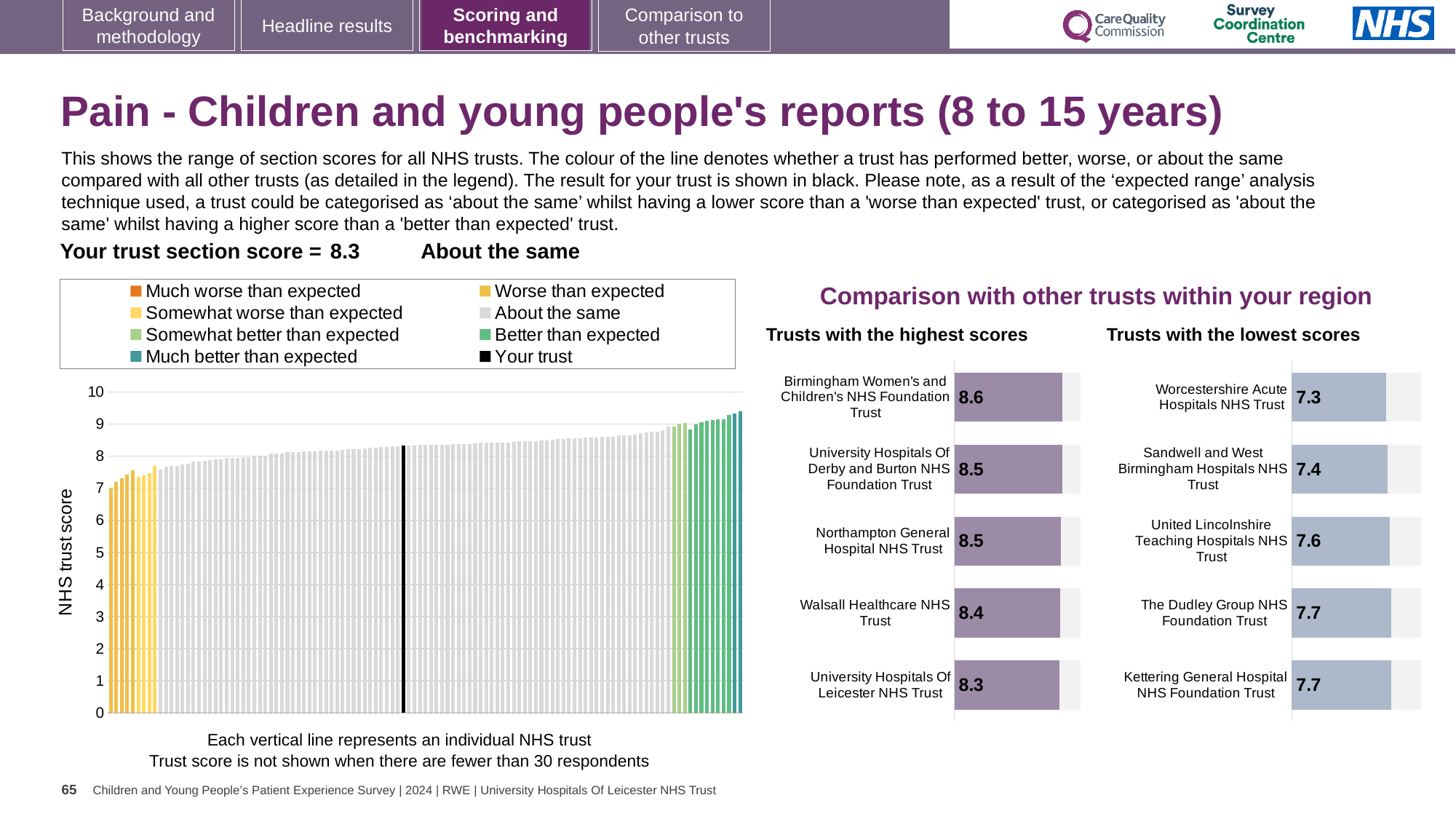
How many entries does the legend of the large chart on the left list? 8 What is the label on the vertical axis of the large chart on the left? NHS trust score What type of chart is the large chart on the left showing NHS trust scores? Bar chart In the 'Trusts with the highest scores' chart, what is the score for Birmingham Women's and Children's NHS Foundation Trust? 8.6 In the large chart on the left, do the trust scores rise or fall from left to right? Rise In the 'Trusts with the lowest scores' chart, which has the higher score: Sandwell and West Birmingham Hospitals NHS Trust or United Lincolnshire Teaching Hospitals NHS Trust? United Lincolnshire Teaching Hospitals NHS Trust In the 'Trusts with the highest scores' chart, how many trusts are listed? 5 In the 'Trusts with the lowest scores' chart, what is the difference between the scores of The Dudley Group NHS Foundation Trust and Worcestershire Acute Hospitals NHS Trust? 0.4 In the 'Trusts with the highest scores' chart, what is the difference between the scores of Birmingham Women's and Children's NHS Foundation Trust and University Hospitals Of Leicester NHS Trust? 0.3 In the 'Trusts with the lowest scores' chart, what is the score for Worcestershire Acute Hospitals NHS Trust? 7.3 In the 'Trusts with the lowest scores' chart, which trust has the lowest score? Worcestershire Acute Hospitals NHS Trust In the 'Trusts with the highest scores' chart, which trust has the lowest score? University Hospitals Of Leicester NHS Trust